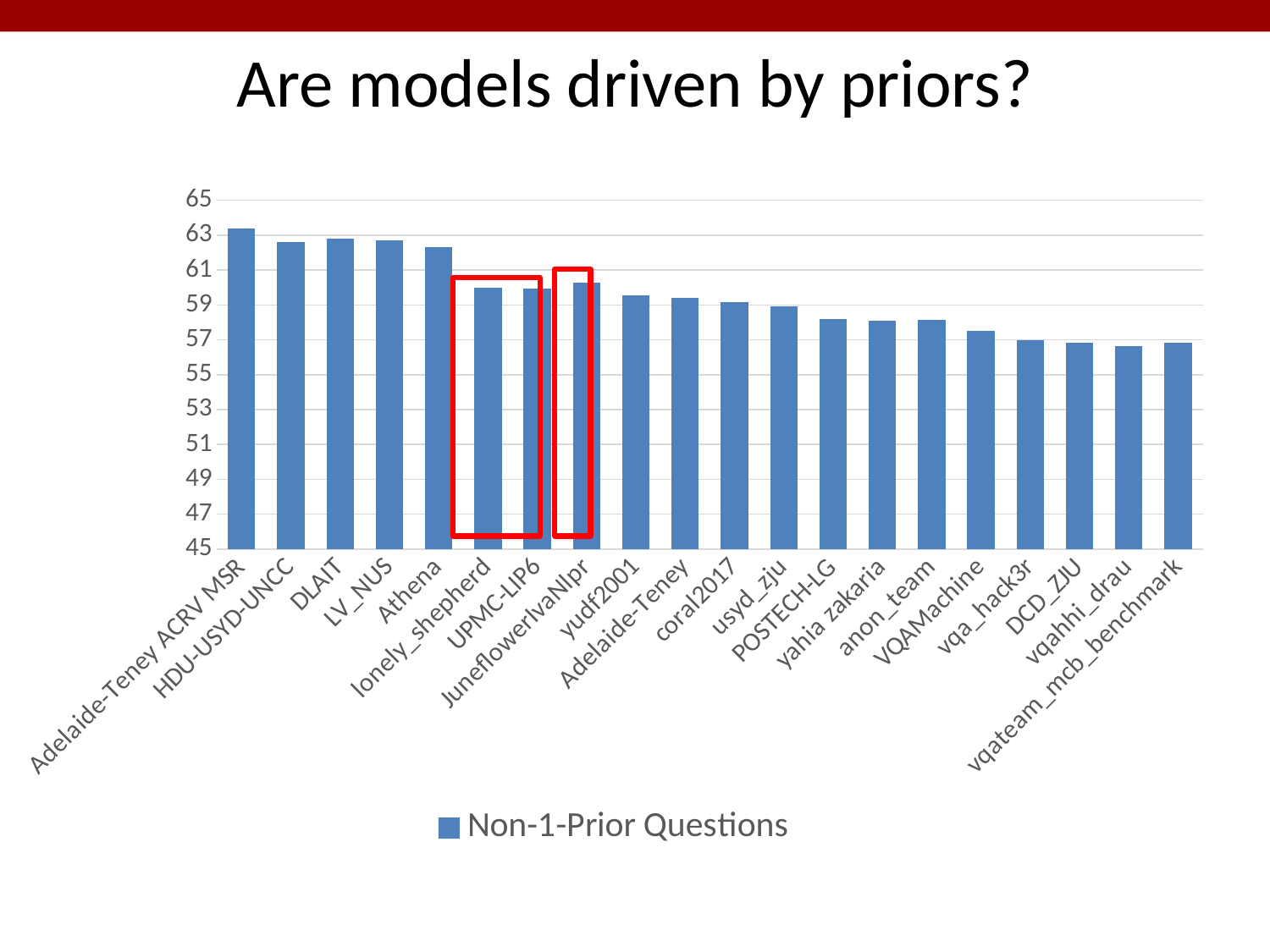
Which category has the highest value? Adelaide-Teney ACRV MSR Do the values generally rise or fall moving from left to right along the x axis? Fall Is the value for Athena greater or less than 63? less How many categories (teams) are plotted along the x axis? 20 What is the name of the series shown in the legend? Non-1-Prior Questions Is the value for anon_team greater or less than 57? greater How many series does the legend list? 1 Which has the larger value, Athena or yudf2001? Athena Which has the larger value, DLAIT or POSTECH-LG? DLAIT Is the value for POSTECH-LG greater or less than 59? less What kind of chart is shown on the slide? Bar chart